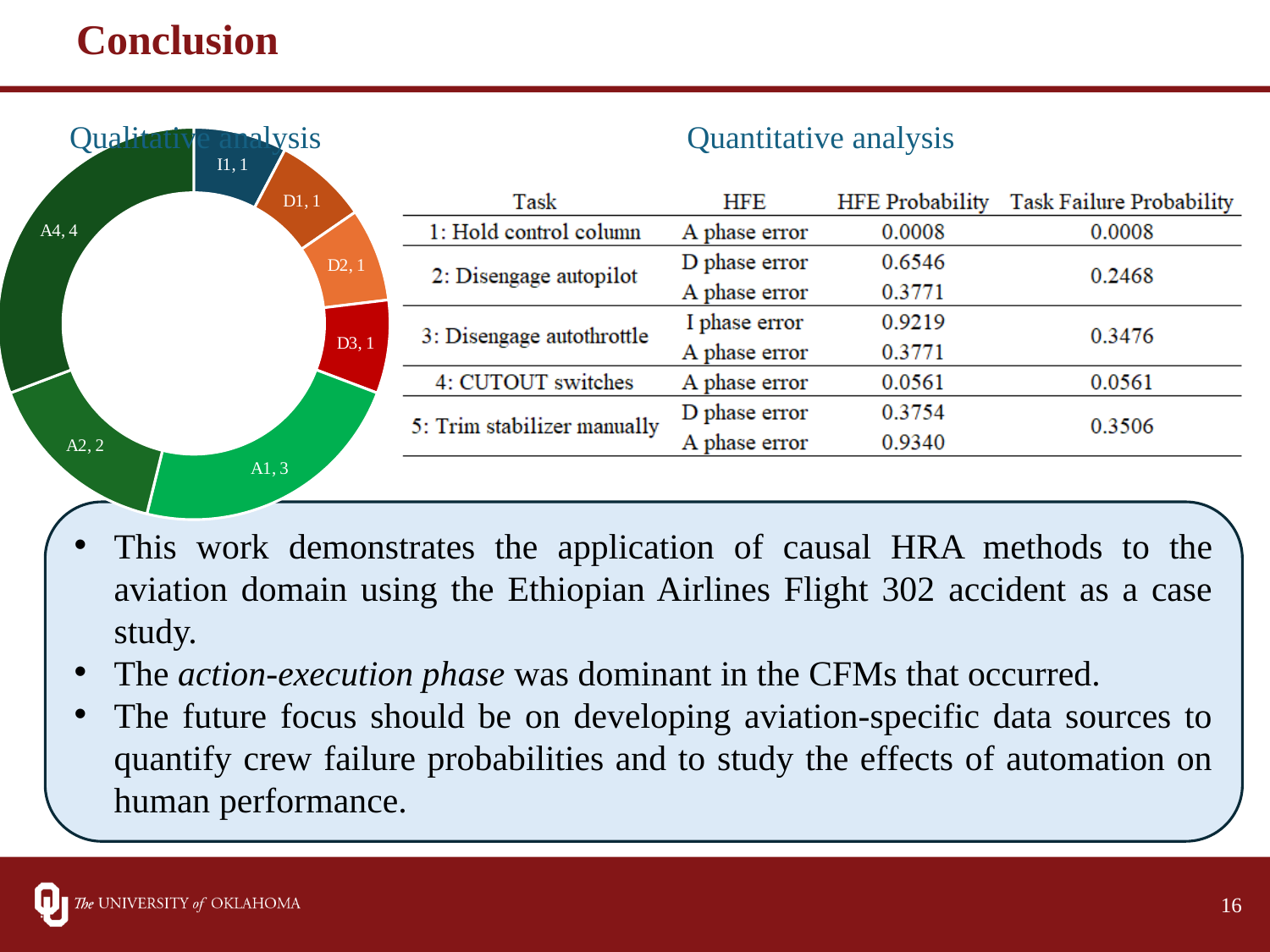
In the Qualitative analysis doughnut chart, what is the value for A4? 4 In the Qualitative analysis doughnut chart, which is larger, the value for A1 or the value for D1? A1 In the Qualitative analysis doughnut chart, which category has the largest value? A4 How many slices does the Qualitative analysis doughnut chart have? 7 What is the heading above the doughnut chart on the left of the slide? Qualitative analysis In the Qualitative analysis doughnut chart, what is the difference between the values for A4 and A2? 2 In the Qualitative analysis doughnut chart, what share of the total does A4 represent? 4 out of 13 In the Qualitative analysis doughnut chart, what is the value for A1? 3 What kind of chart is shown under the heading 'Qualitative analysis'? doughnut chart In the Qualitative analysis doughnut chart, what is the value for A2? 2 In the Qualitative analysis doughnut chart, what is the value for D3? 1 In the Qualitative analysis doughnut chart, what is the total of all slice values? 13